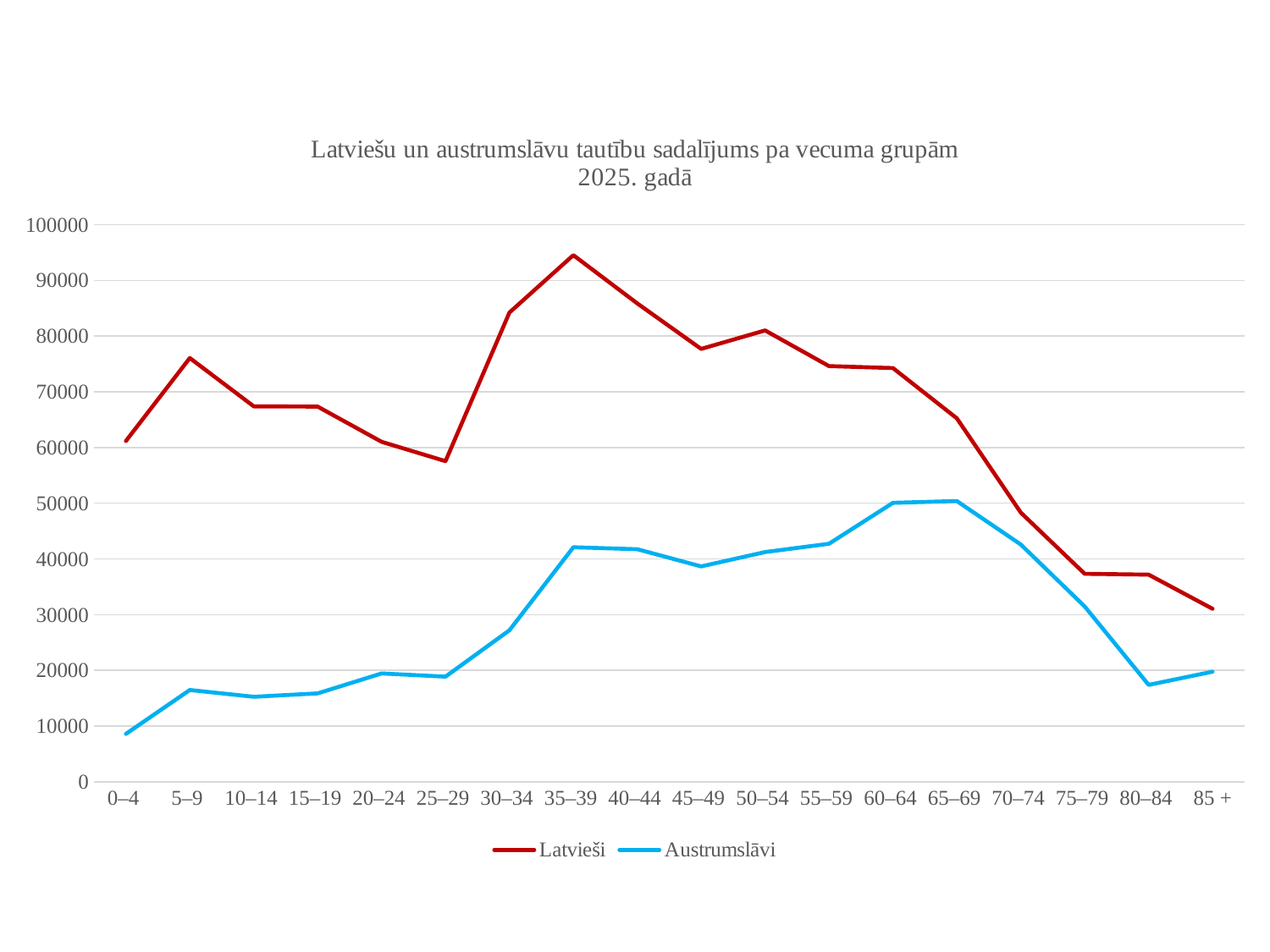
Which age group has the lowest value for Latvieši? 85 + Is the value for Latvieši in the 25–29 age group greater or less than 60000? less Which age group has the highest value for Latvieši? 35–39 What is the title of the chart? Latviešu un austrumslāvu tautību sadalījums pa vecuma grupām 2025. gadā How many age groups are shown on the x axis? 18 What kind of chart is shown on the slide? line chart Which series has the larger value in the 40–44 age group, Latvieši or Austrumslāvi? Latvieši Which age group has the lowest value for Austrumslāvi? 0–4 Is the value for Austrumslāvi in the 0–4 age group greater or less than 10000? less How many series does the legend list? 2 Is the value for Latvieši in the 35–39 age group greater or less than 90000? greater Does the Latvieši line rise or fall from the 35–39 age group to the 85 + age group? fall